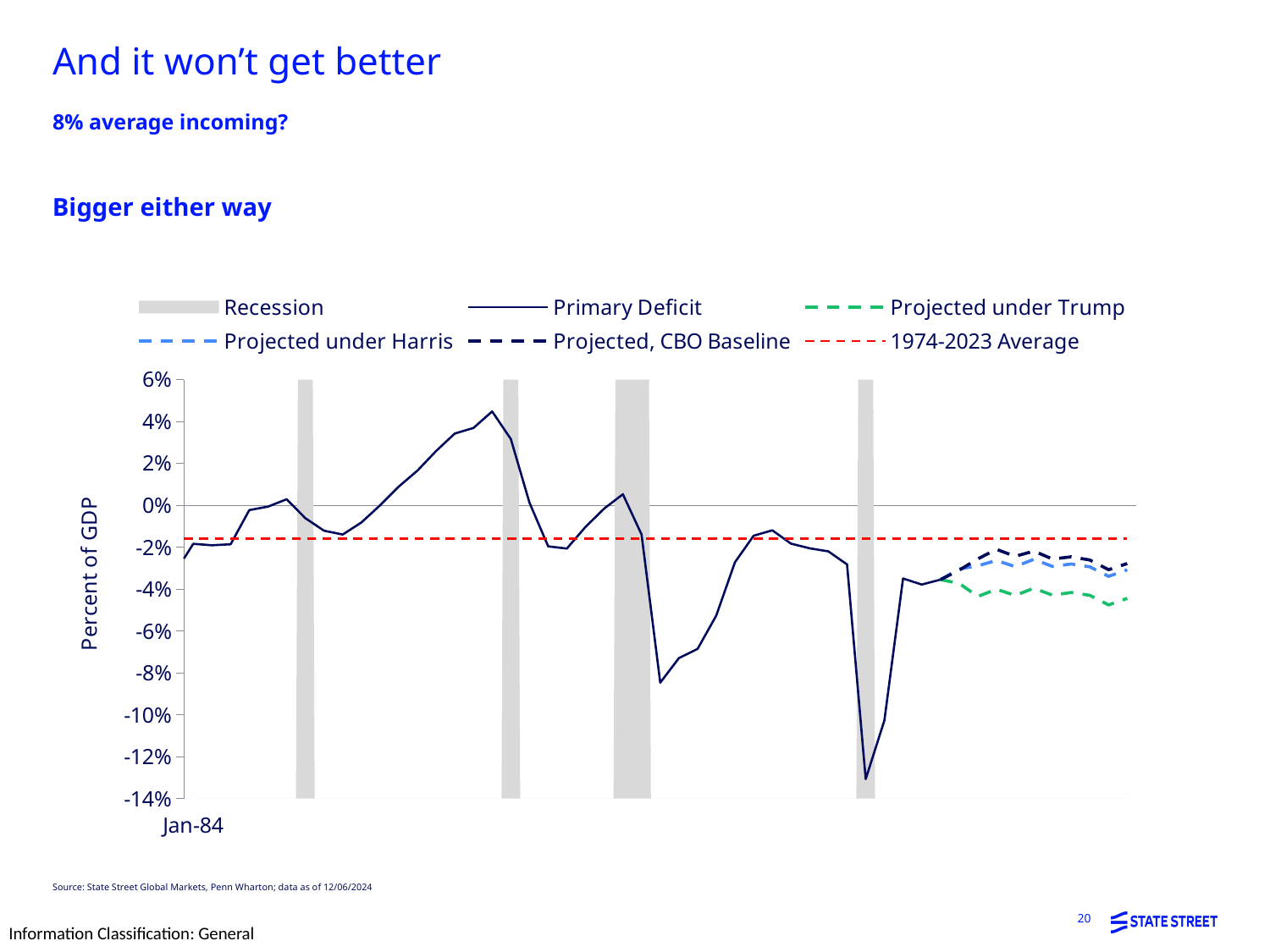
What is the title of the vertical axis of the chart? Percent of GDP Of the three projected series, which one lies lowest on the chart? Projected under Trump How many grey Recession bands are shaded on the chart? 4 What is the highest value shown on the vertical axis of the chart? 6% Is the 1974-2023 Average line greater or less than 0%? less How many entries does the chart's legend list? 6 What kind of chart is shown on the slide? line chart Is the lowest point of the Primary Deficit line greater or less than -12%? less Is the highest point of the Primary Deficit line greater or less than 2%? greater What is the only date label shown on the horizontal axis of the chart? Jan-84 Which projected line is lower at the right end of the chart, Projected under Trump or Projected under Harris? Projected under Trump